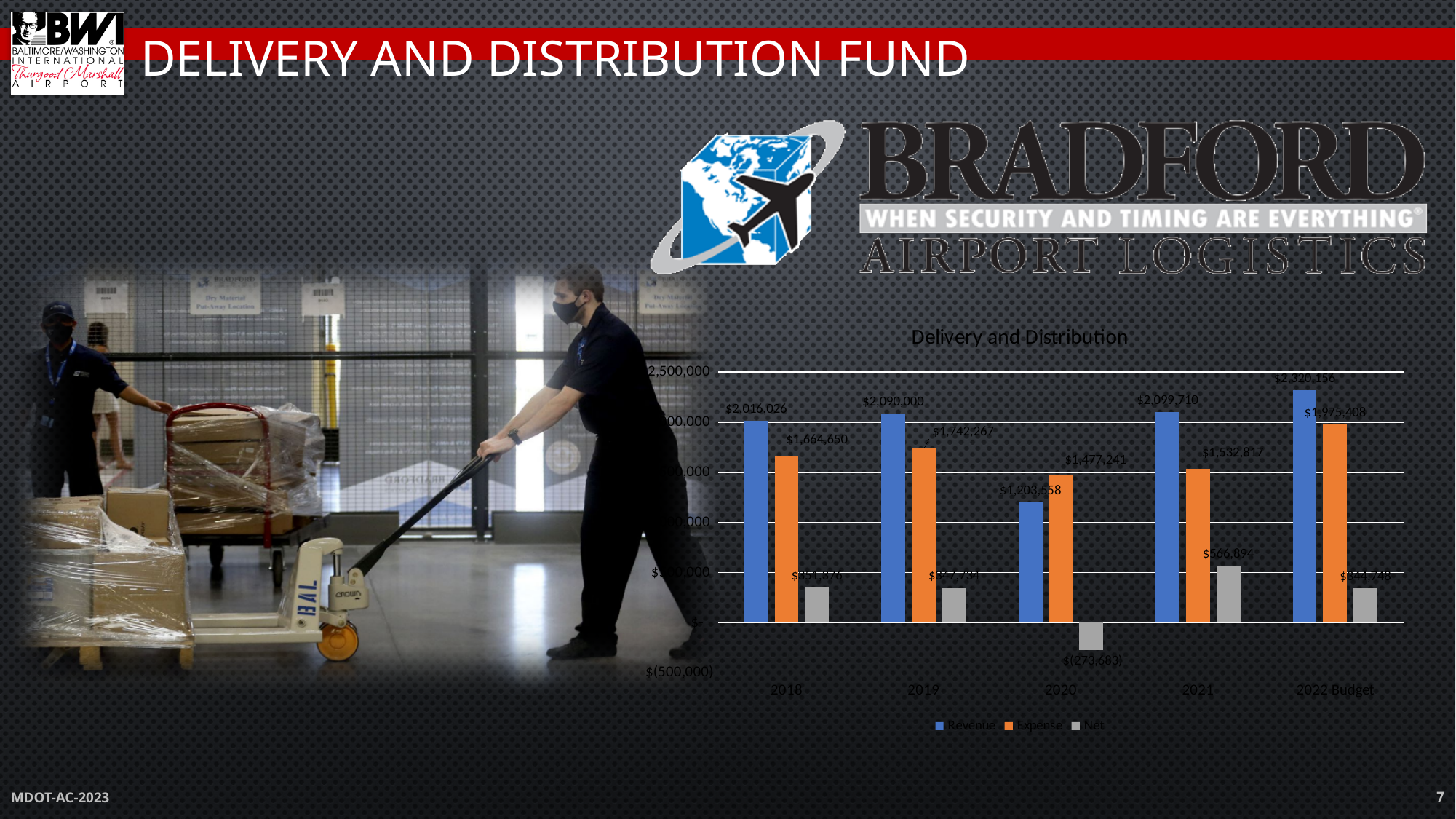
In 2020, which is larger, Revenue or Expense? Expense What is the Net value for 2021? $566,894 What is the Net value for 2020? $(273,683) What is the title of the chart? Delivery and Distribution Which category has the highest Revenue? 2022 Budget What is the Expense value for 2020? $1,477,241 What is the difference between the Revenue for 2019 and the Revenue for 2018? $73,974 How many series does the legend of the chart list? 3 What is the Revenue value for 2018? $2,016,026 How many categories are shown along the x axis of the chart? 5 What kind of chart is shown on the slide? bar chart Which category has the lowest Revenue? 2020